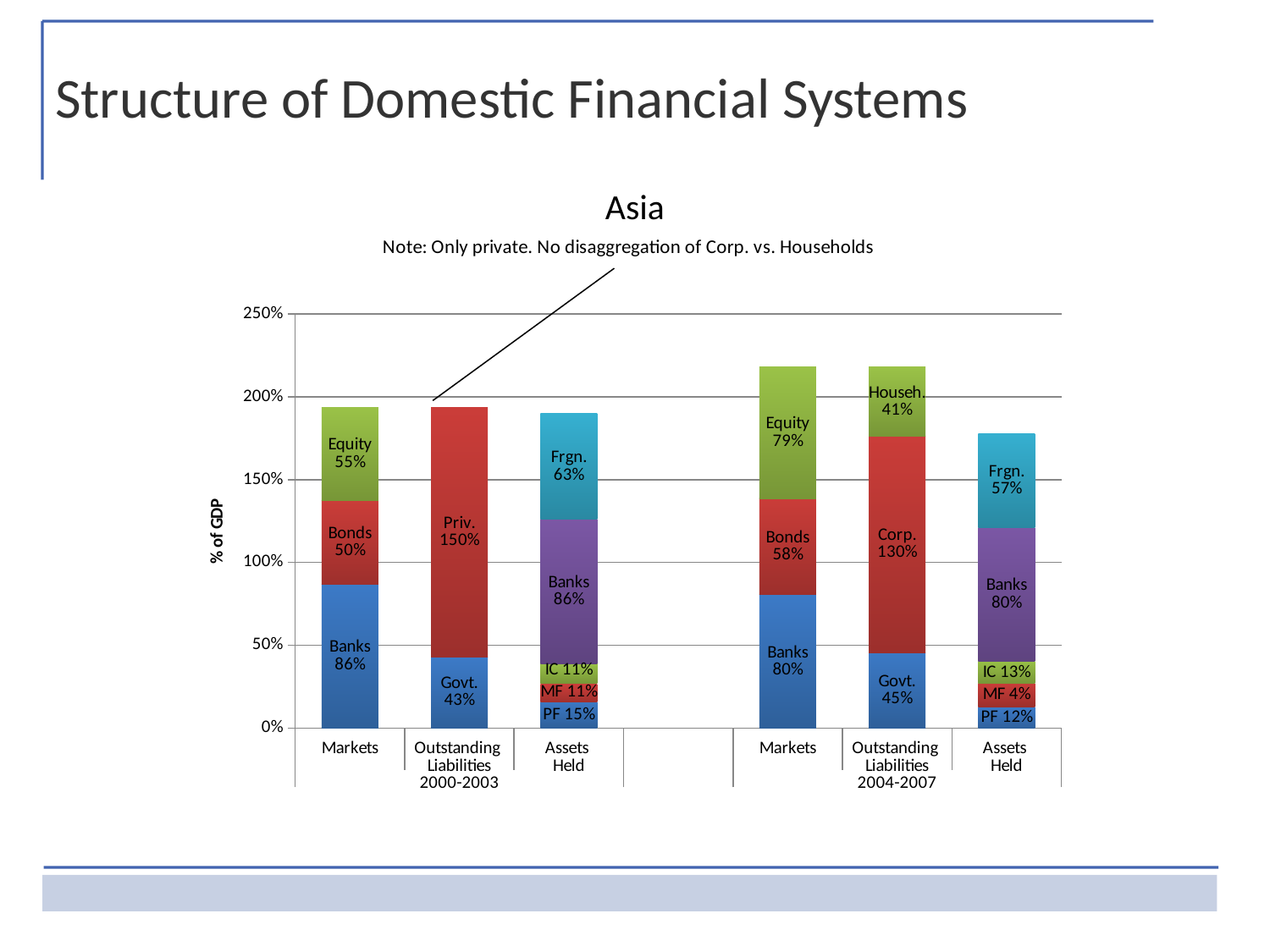
What is the MF value for Assets Held in 2004-2007? 4% What is the difference between the Equity value for Markets in 2004-2007 and the Equity value for Markets in 2000-2003? 24% What is the total of the Outstanding Liabilities bar for 2000-2003 (Govt. plus Priv.)? 193% What is the Frgn. value for Assets Held in 2004-2007? 57% What type of chart is shown on the slide? Stacked bar chart Is the total height of the Markets bar for 2004-2007 greater or less than 200%? greater What is the Corp. value for Outstanding Liabilities in 2004-2007? 130% What is the Priv. value for Outstanding Liabilities in 2000-2003? 150% How many bars are plotted in the chart? 6 What is the label of the vertical axis? % of GDP What is the Banks value for Markets in 2000-2003? 86% Which is larger: the Bonds value for Markets in 2000-2003 or the Bonds value for Markets in 2004-2007? Markets in 2004-2007